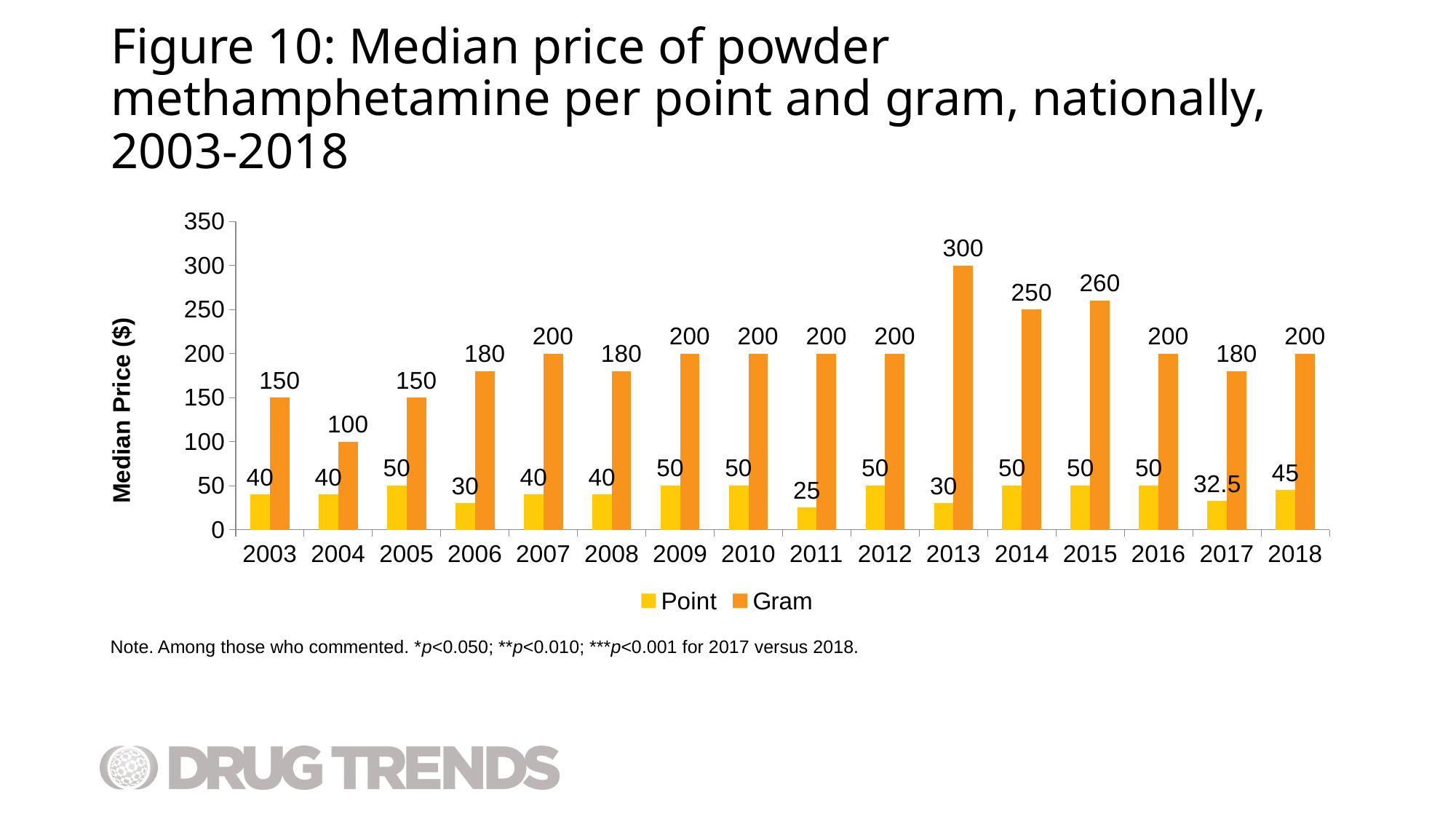
What is the median price per gram in 2013? 300 In which year is the median price per gram highest? 2013 Which is larger, the median price per gram in 2015 or in 2016? 2015 How many years are shown on the x axis? 16 What kind of chart is shown on the slide? Bar chart In which year is the median price per gram lowest? 2004 Which series is shown in yellow? Point What is the median price per point in 2017? 32.5 How many series does the legend list? 2 What is the difference between the median price per gram in 2013 and in 2014? 50 What is the label of the y axis? Median Price ($) What is the median price per point in 2011? 25